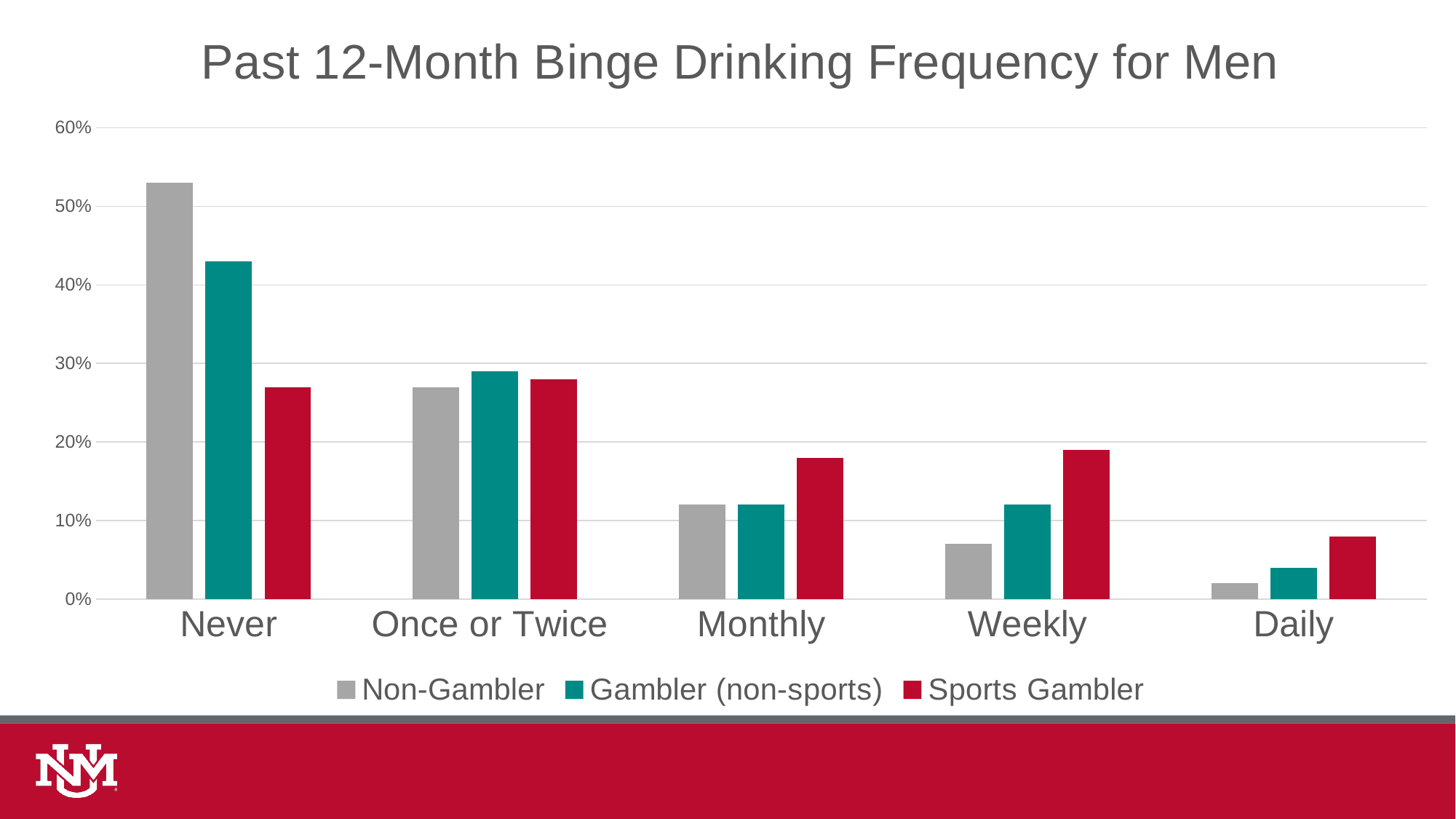
In the Daily category, which is larger: Sports Gambler or Gambler (non-sports)? Sports Gambler What kind of chart is shown on the slide? bar chart How many series does the legend list? 3 Which series has the highest value in the Never category? Non-Gambler Which series has the lowest value in the Weekly category? Non-Gambler Is the value for Sports Gambler in the Never category greater or less than 30%? less How many categories are shown on the x axis? 5 Is the value for Non-Gambler in the Weekly category greater or less than 10%? less Is the value for Gambler (non-sports) in the Never category greater or less than 40%? greater Do the Non-Gambler values rise or fall from Never to Daily along the x axis? fall